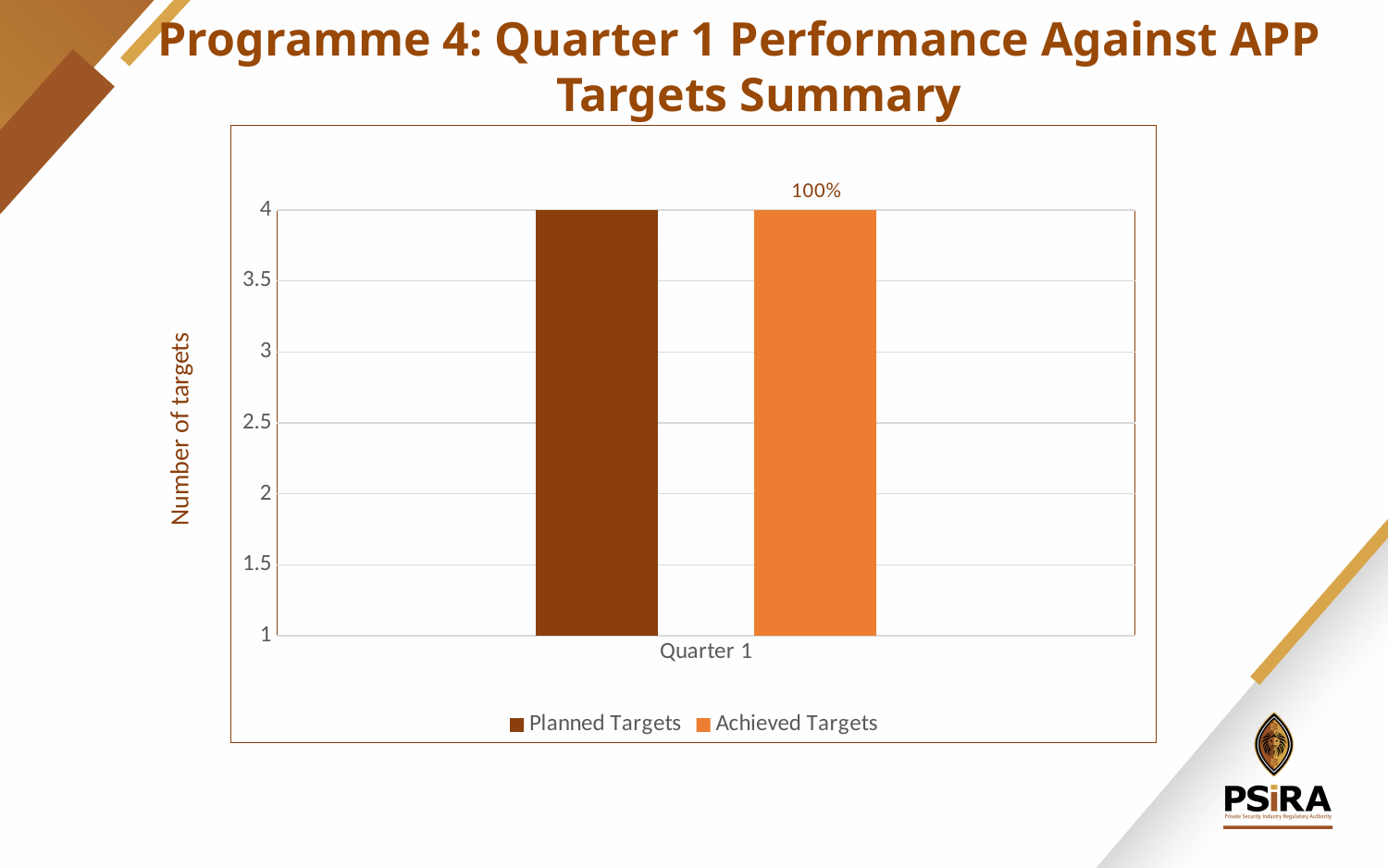
What is the value of Achieved Targets for Quarter 1? 4 What is the label of the y axis? Number of targets What kind of chart is shown on the slide? Bar chart What data label is printed above the Achieved Targets bar? 100% How many categories are shown on the x axis? 1 Is the value for Planned Targets in Quarter 1 greater or less than 3? greater How many series does the legend list? 2 Is the value for Achieved Targets in Quarter 1 greater or less than 2? greater What is the value of Planned Targets for Quarter 1? 4 What is the difference between Planned Targets and Achieved Targets for Quarter 1? 0 Which series is shown in orange? Achieved Targets